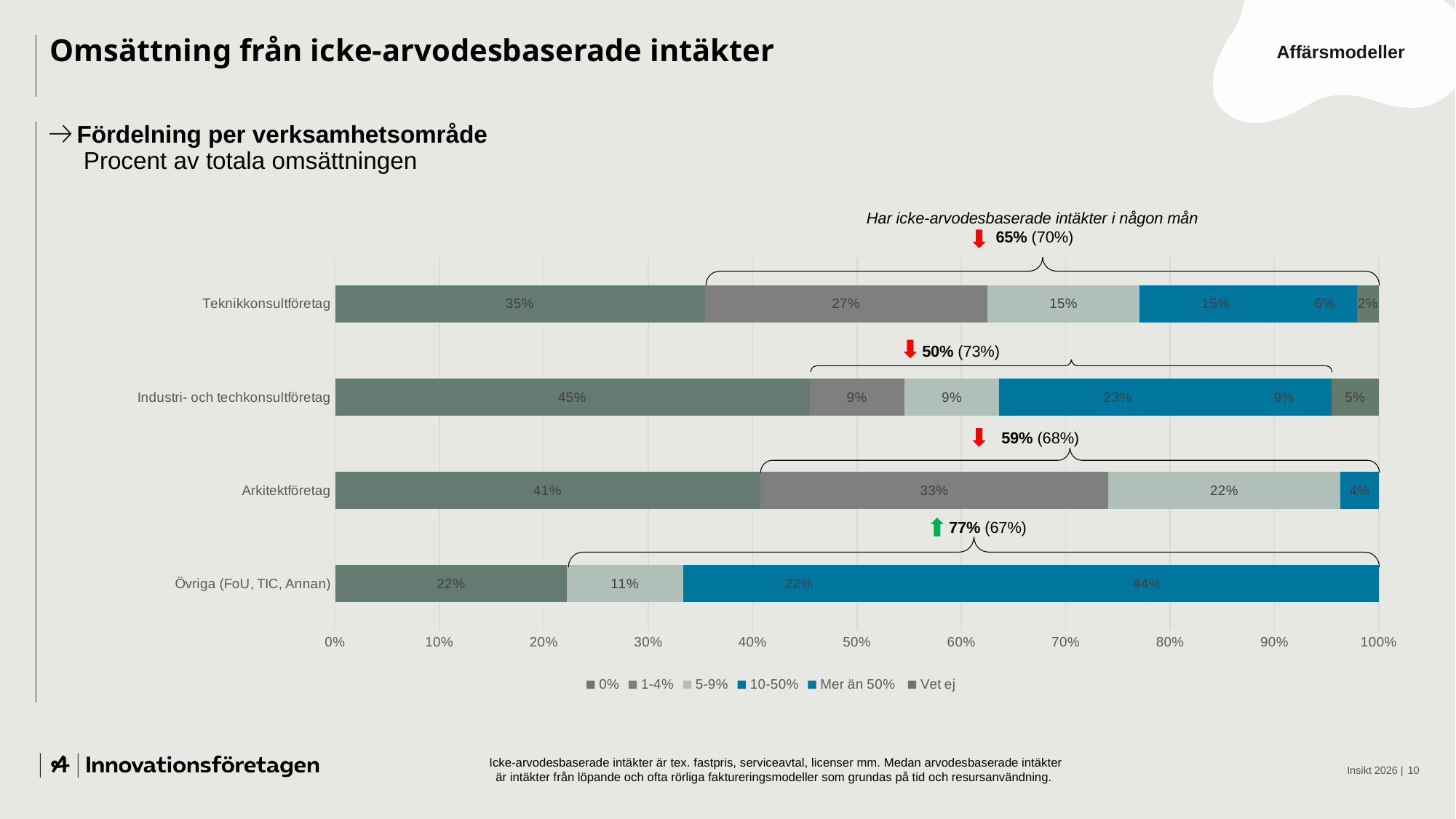
Which category has the smallest 0% segment? Övriga (FoU, TIC, Annan) What kind of chart is shown on the slide? Stacked bar chart What is the value of the 5-9% segment for Arkitektföretag? 22% What is the value of the 10-50% segment for Industri- och techkonsultföretag? 23% What is the difference between the 0% segment for Arkitektföretag and the 0% segment for Teknikkonsultföretag? 6 percentage points What is the value of the 0% segment for Industri- och techkonsultföretag? 45% How many categories (business areas) are shown in the chart? 4 Which has a larger 1-4% segment, Teknikkonsultföretag or Arkitektföretag? Arkitektföretag How many series does the legend list? 6 What percentage of Teknikkonsultföretag report 0% non-fee-based revenue? 35% Which category has the largest 0% segment? Industri- och techkonsultföretag What is the value of the 1-4% segment for Arkitektföretag? 33%